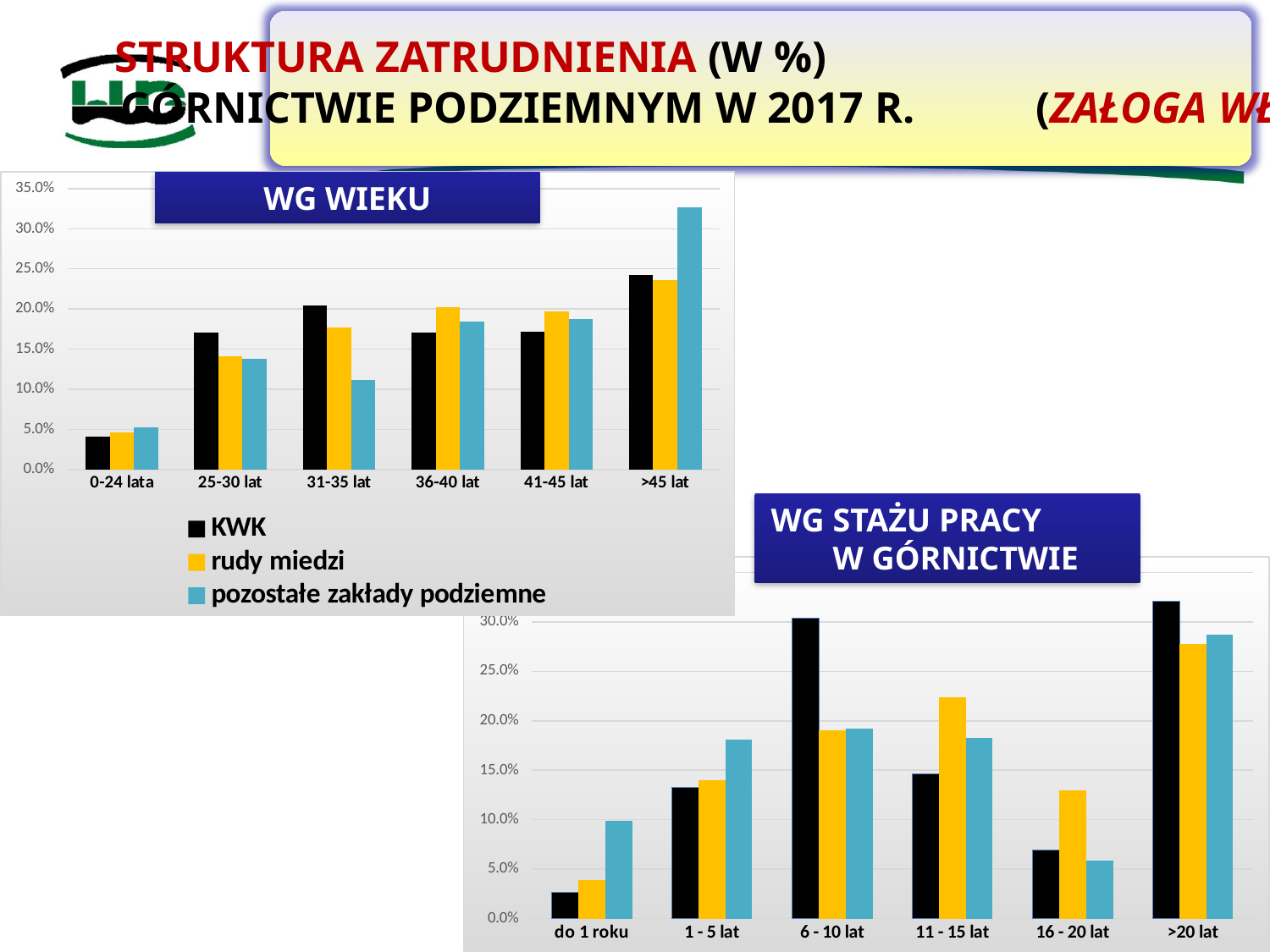
In the 'WG WIEKU' chart, which age category has the highest value for 'pozostałe zakłady podziemne'? >45 lat How many tenure categories are shown on the x axis of the 'WG STAŻU PRACY W GÓRNICTWIE' chart? 6 In the 'WG STAŻU PRACY W GÓRNICTWIE' chart, which tenure category has the highest black bar? >20 lat In the 'WG STAŻU PRACY W GÓRNICTWIE' chart, for the '16 - 20 lat' category, which bar is larger: the black bar or the yellow bar? the yellow bar How many age categories are shown on the x axis of the 'WG WIEKU' chart? 6 In the 'WG WIEKU' chart, is the value for 'pozostałe zakłady podziemne' in the '>45 lat' category greater or less than 30.0%? greater In the 'WG WIEKU' chart, for the '31-35 lat' category, which series has the larger value: 'KWK' or 'pozostałe zakłady podziemne'? KWK What kind of chart is the 'WG WIEKU' chart? bar chart In the 'WG WIEKU' chart, is the value for 'pozostałe zakłady podziemne' in the '31-35 lat' category greater or less than 15.0%? less How many series does the legend of the 'WG WIEKU' chart list? 3 In the 'WG WIEKU' chart, which age category has the lowest value for 'KWK'? 0-24 lata